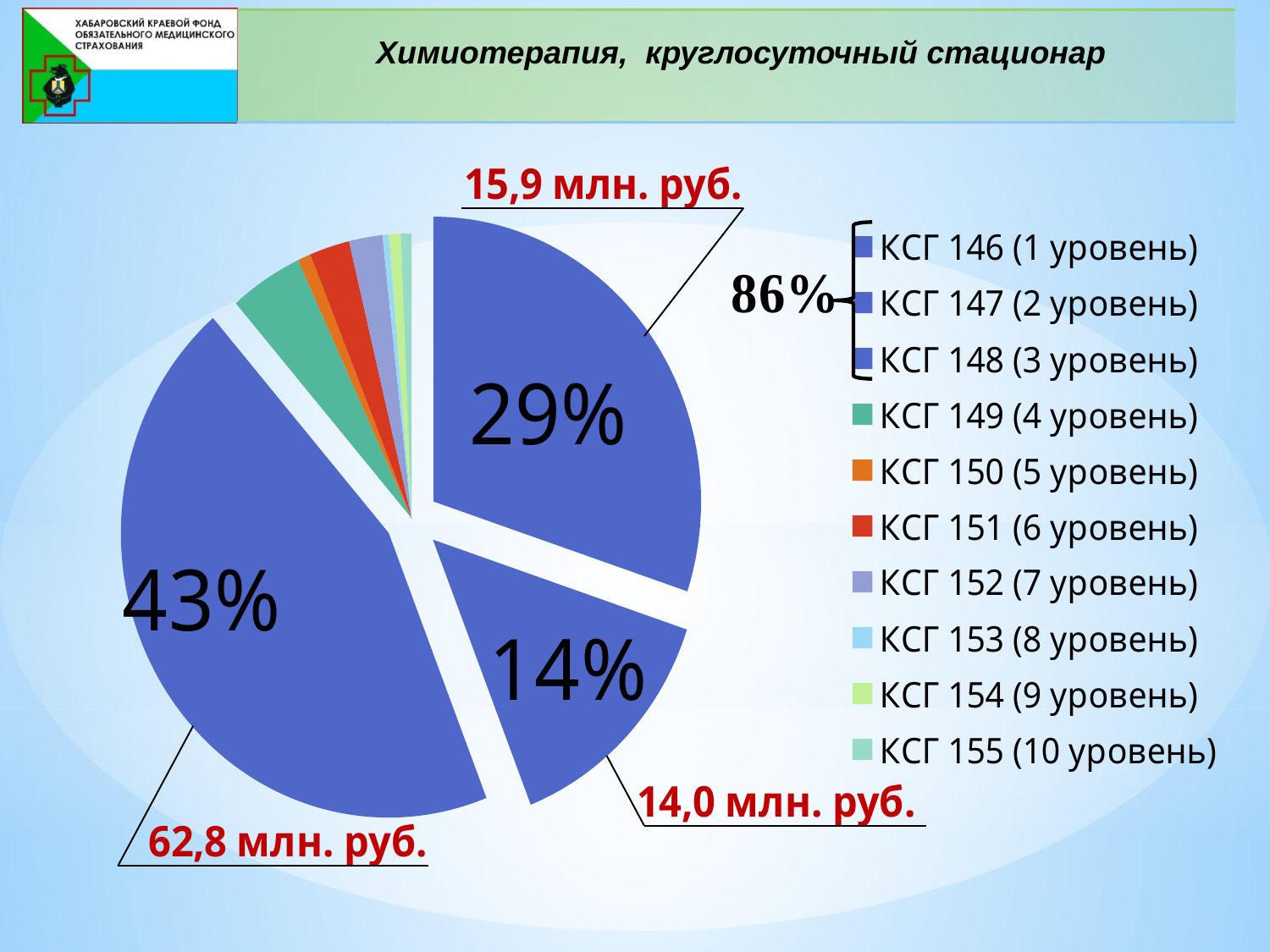
What is the title of the slide containing the pie chart? Химиотерапия, круглосуточный стационар What combined share is shown for the three slices КСГ 146, КСГ 147 and КСГ 148 (levels 1–3)? 86% How many categories (КСГ entries) does the legend of the pie chart list? 10 What is the percentage of the largest slice in the pie chart? 43% What is the difference in percentage points between the 43% slice and the 14% slice? 29 percentage points What amount in млн. руб. is labelled on the 14% slice of the pie chart? 14,0 млн. руб. What amount in млн. руб. is labelled on the 29% slice of the pie chart? 15,9 млн. руб. What type of chart is shown on the slide? Pie chart Which legend entries are grouped by the bracket marked 86%? КСГ 146 (1 уровень), КСГ 147 (2 уровень), КСГ 148 (3 уровень) Which is larger: the slice labelled 15,9 млн. руб. or the slice labelled 14,0 млн. руб.? The slice labelled 15,9 млн. руб. (29%) What amount in млн. руб. is labelled on the 43% slice of the pie chart? 62,8 млн. руб. What is the difference between the amounts 62,8 млн. руб. and 14,0 млн. руб. shown on the pie chart? 48,8 млн. руб.